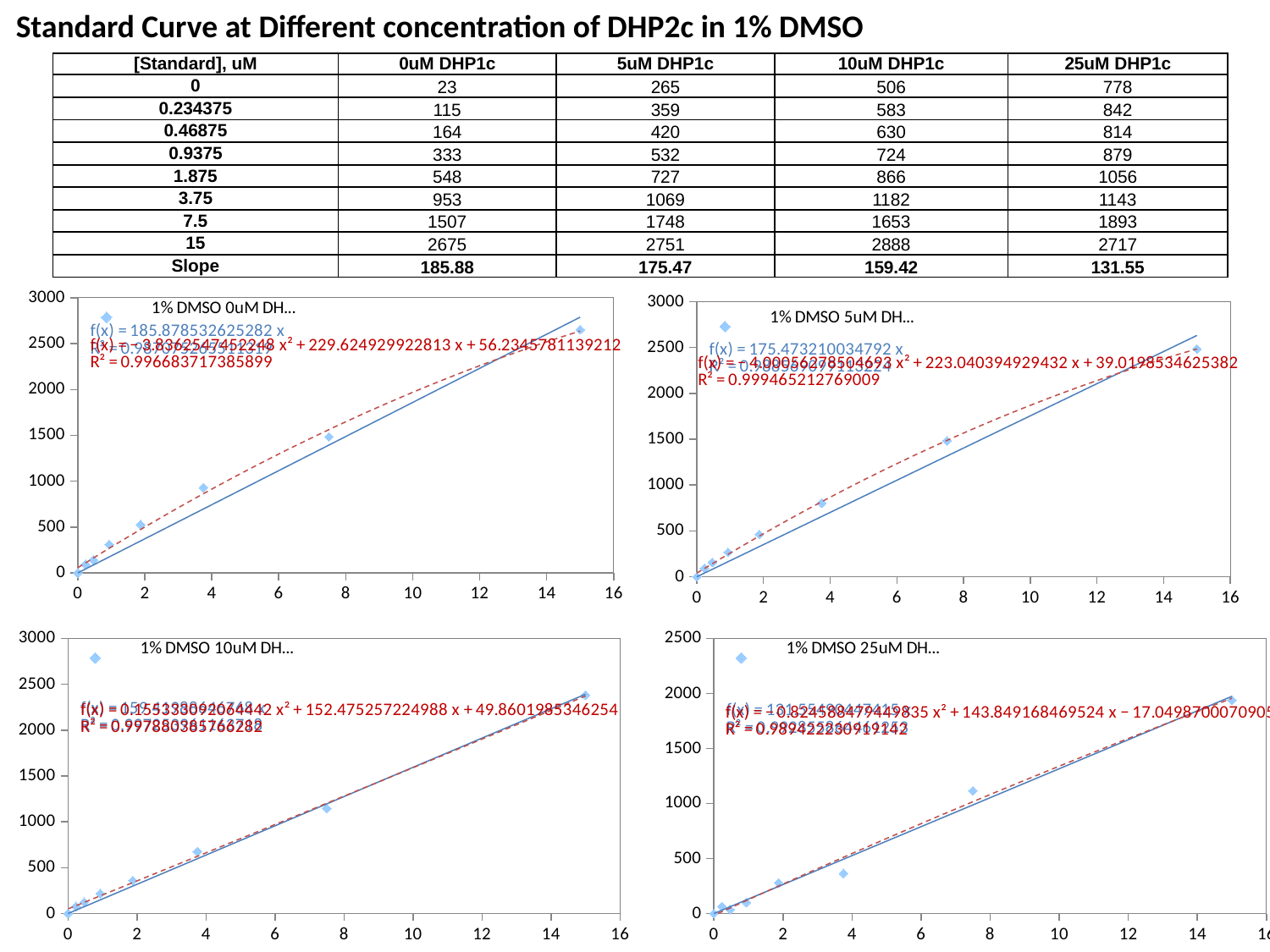
What kind of chart is the top-left chart titled "1% DMSO 0uM DH..."? scatter chart In the bottom-right chart (1% DMSO 25uM DH...), is the value at x = 3.75 greater or less than 500? less In the top-left chart (1% DMSO 0uM DH...), is the value at x = 15 greater or less than 2500? greater In the bottom-left chart (1% DMSO 10uM DH...), do the plotted values rise or fall along the x axis? rise What is the maximum value shown on the y axis of the bottom-right chart (1% DMSO 25uM DH...)? 2500 What is the maximum value shown on the x axis of the top-right chart (1% DMSO 5uM DH...)? 16 In the top-right chart (1% DMSO 5uM DH...), is the value at x = 7.5 greater or less than 1000? greater How many data points are plotted in the top-left chart (1% DMSO 0uM DH...)? 8 In the top-left chart (1% DMSO 0uM DH...), do the plotted values rise or fall as the x value increases? rise How many data points are plotted in the bottom-right chart (1% DMSO 25uM DH...)? 8